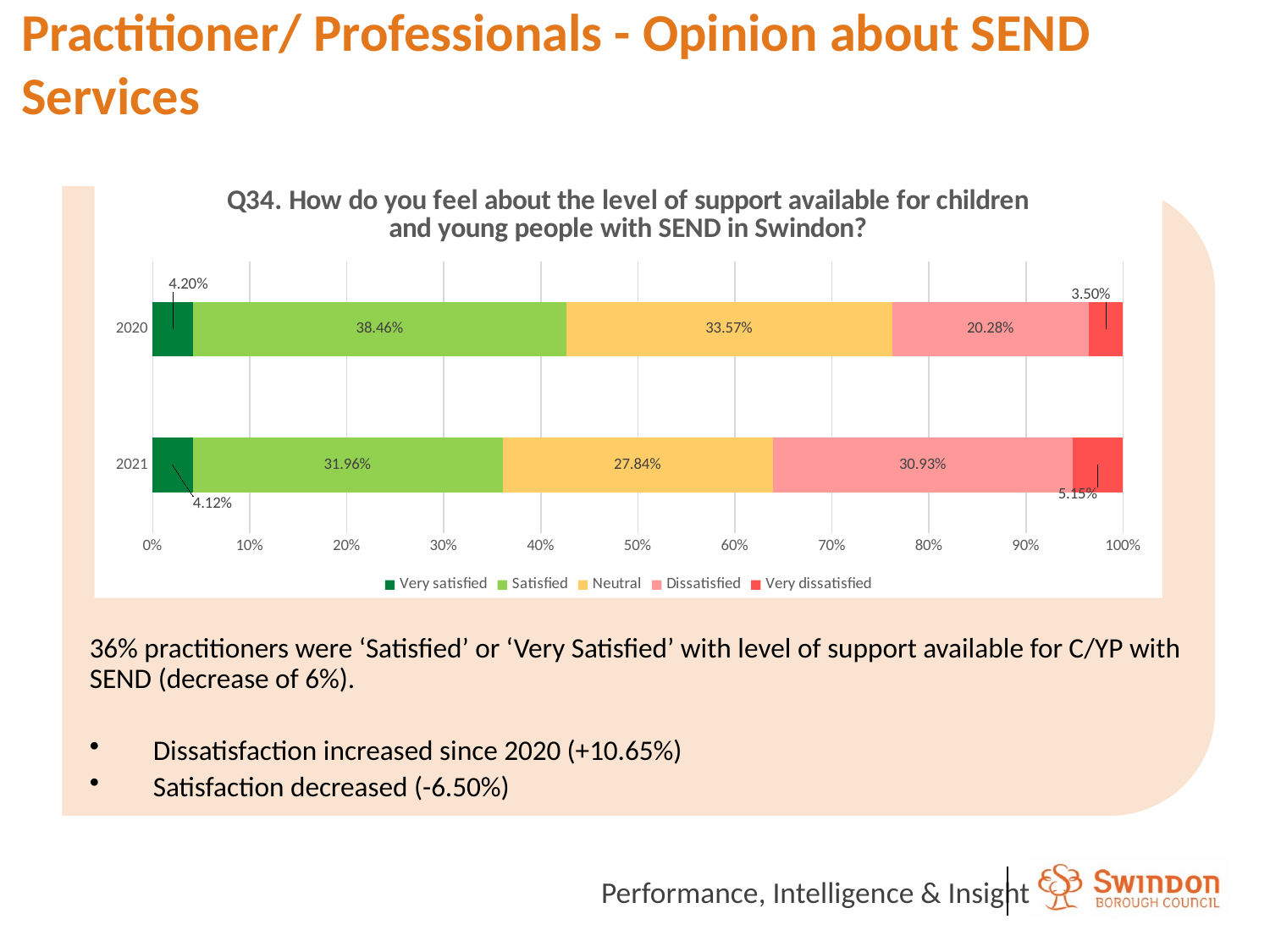
What is the difference between the 'Satisfied' values for 2020 and 2021? 6.50% How many years (categories) are plotted on the chart? 2 What kind of chart is shown on the slide? Stacked bar chart What is the 'Very satisfied' value for 2021? 4.12% What percentage of practitioners were 'Dissatisfied' in 2021? 30.93% What is the 'Very dissatisfied' value for 2020? 3.50% Which year has the higher 'Dissatisfied' percentage, 2020 or 2021? 2021 Which series is shown in dark green in the legend? Very satisfied What percentage of practitioners were 'Satisfied' in 2020? 38.46% What is the difference between the 'Dissatisfied' values for 2021 and 2020? 10.65% What is the 'Neutral' value for 2021? 27.84% How many series does the legend list? 5